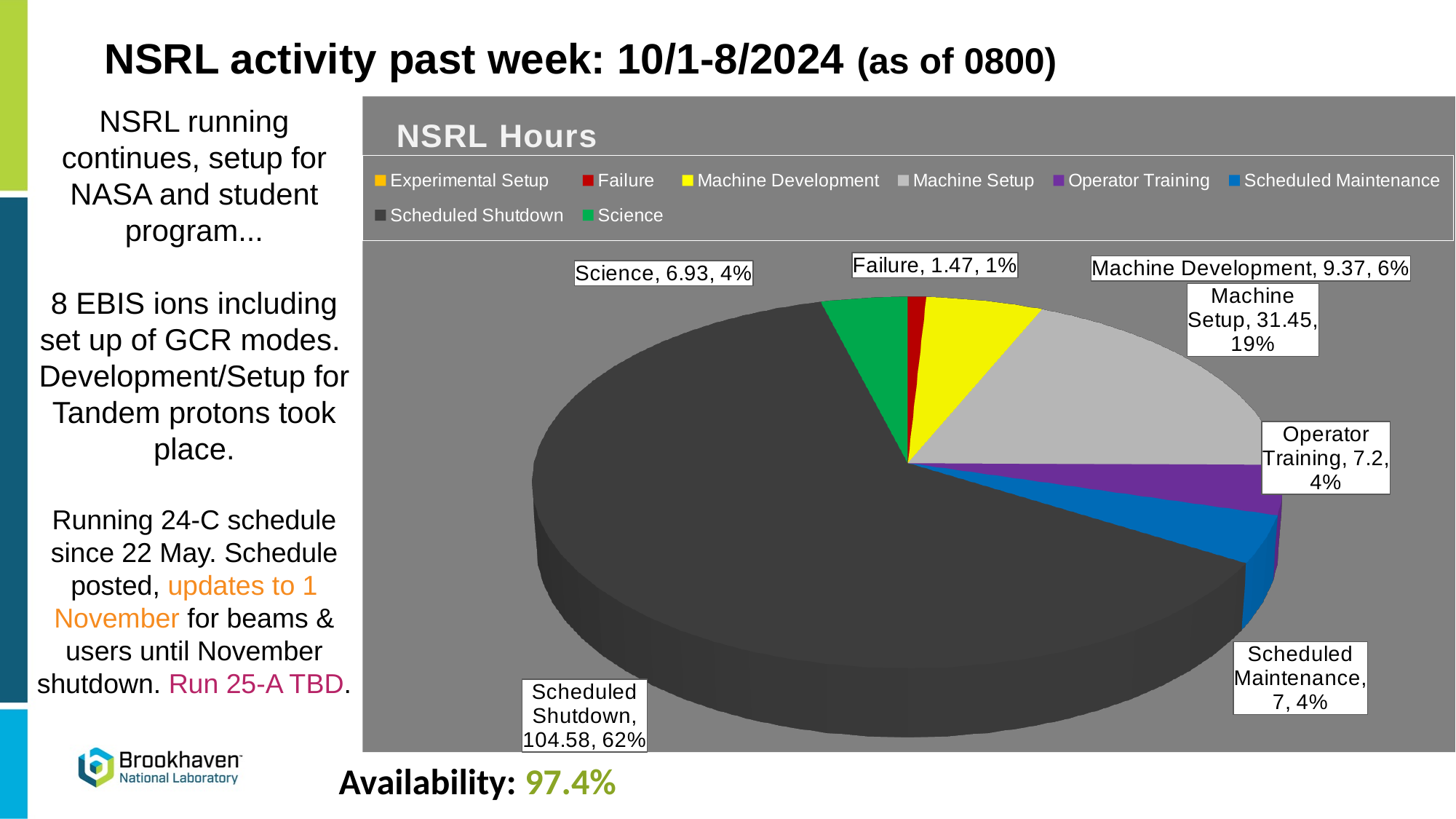
What is the difference in hours between Machine Setup and Machine Development? 22.08 What percentage share of the pie is Machine Development? 6% How many hours are shown for Machine Setup? 31.45 What is the title of the chart? NSRL Hours What percentage share of the pie is Scheduled Shutdown? 62% Which category has the largest slice of the pie? Scheduled Shutdown Which labelled category has the smallest slice of the pie? Failure Which has more hours, Science or Operator Training? Operator Training What type of chart is shown on the slide? pie chart How many entries does the chart legend list? 8 How many hours are shown for Failure? 1.47 How many hours are shown for Scheduled Shutdown? 104.58